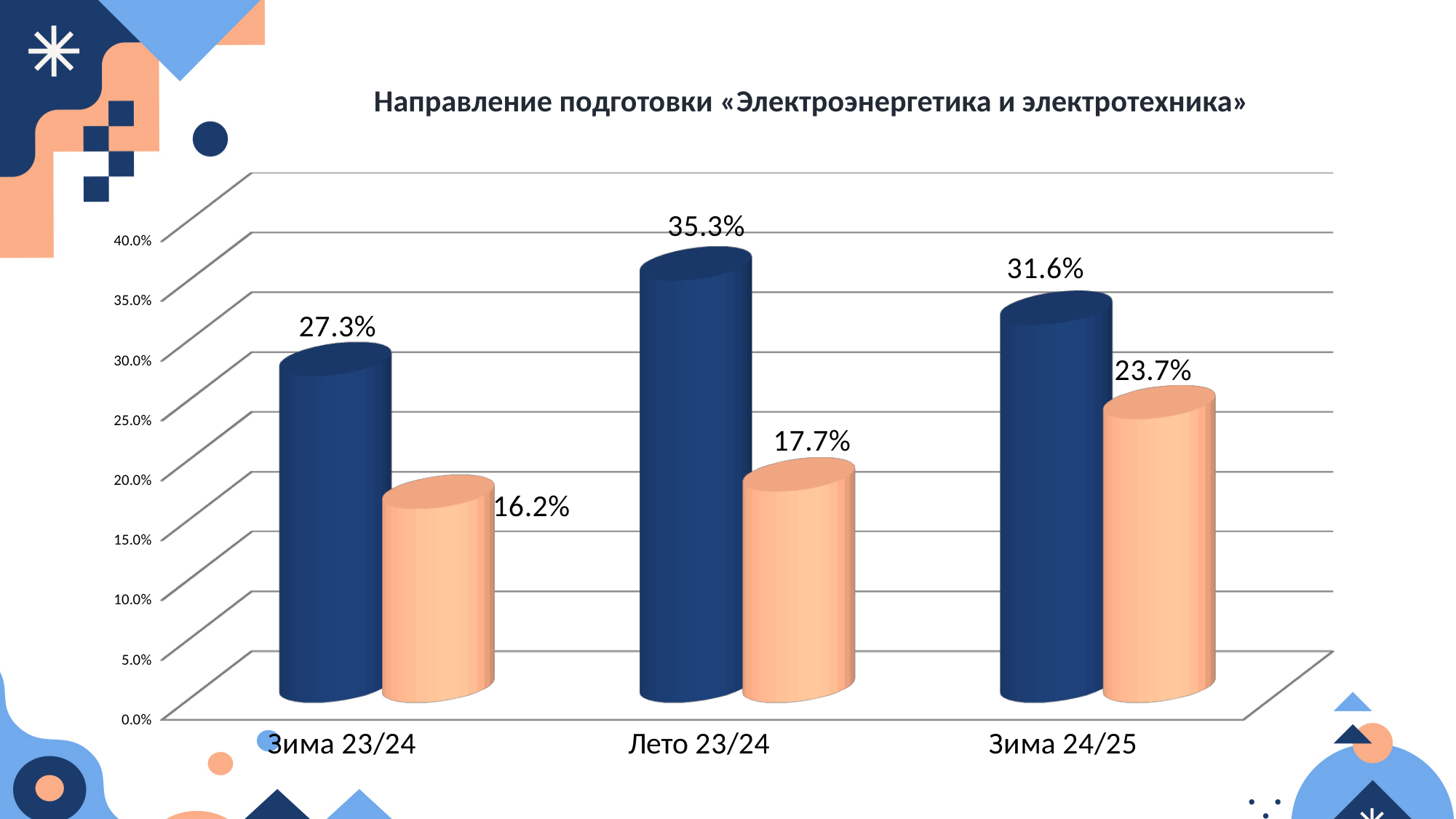
What is the value of the orange bar for Лето 23/24? 17.7% What is the difference between the orange bars for Зима 24/25 and Зима 23/24? 7.5% What type of chart is shown on the slide? Bar chart Which is larger: the dark blue bar for Зима 23/24 or the dark blue bar for Зима 24/25? Зима 24/25 What is the difference between the dark blue and orange bars for Лето 23/24? 17.6% Which category has the lowest orange bar? Зима 23/24 Do the orange bars rise or fall from Зима 23/24 to Зима 24/25? Rise What is the value of the dark blue bar for Зима 24/25? 31.6% How many categories are shown on the x axis? 3 What is the value of the orange bar for Зима 24/25? 23.7% What is the value of the dark blue bar for Зима 23/24? 27.3% Which category has the highest dark blue bar? Лето 23/24